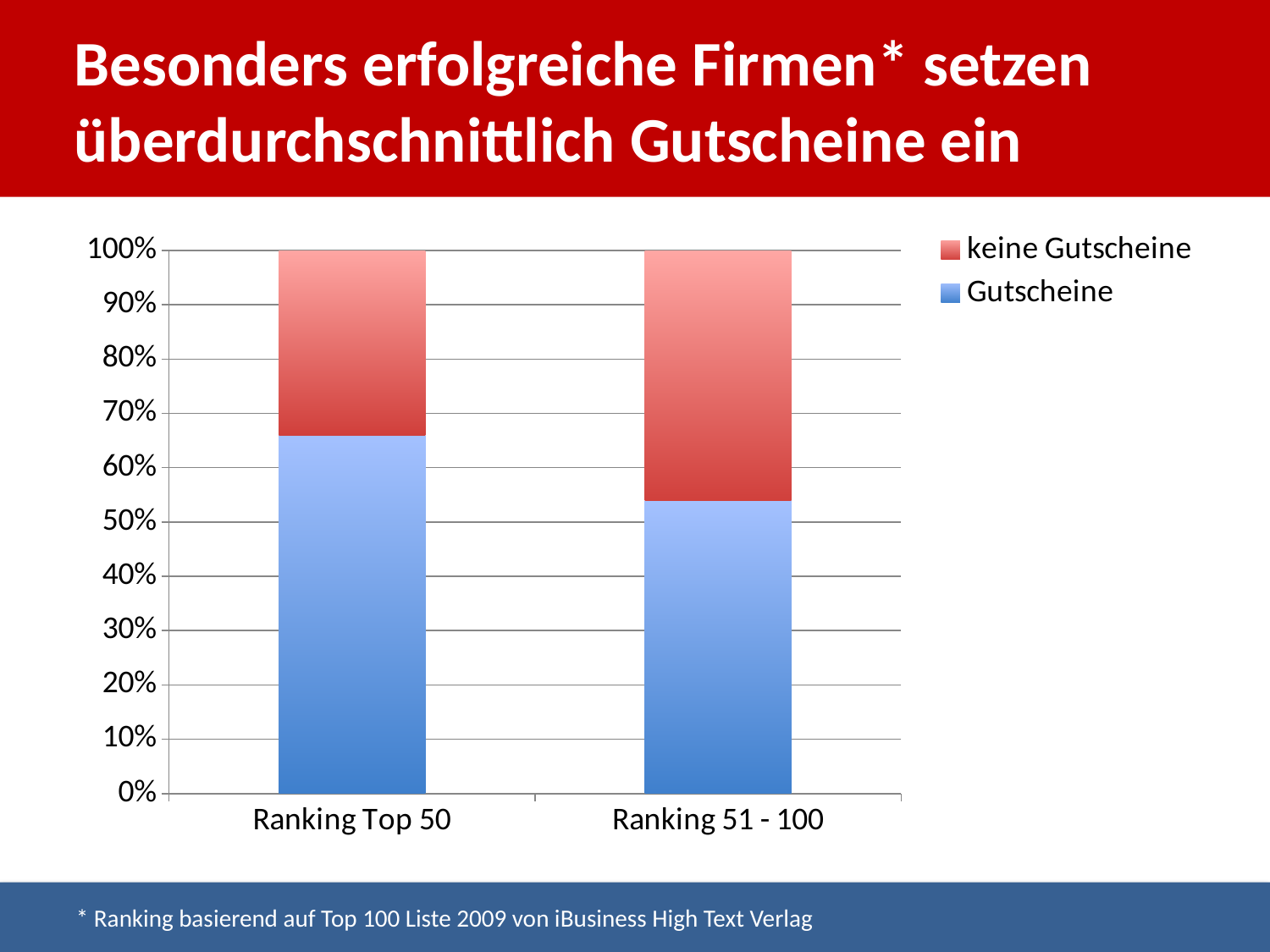
Is the 'Gutscheine' value for Ranking Top 50 greater or less than 70%? less Is the 'Gutscheine' value for Ranking 51 - 100 greater or less than 50%? greater What colour represents the series 'Gutscheine' in the chart? blue How many categories are shown on the x axis of the chart? 2 What is the total height of the stacked bar for Ranking Top 50? 100% How many series does the chart's legend list? 2 Which category has the larger 'keine Gutscheine' share, Ranking Top 50 or Ranking 51 - 100? Ranking 51 - 100 What kind of chart is shown on the slide? stacked bar chart Is the 'Gutscheine' value for Ranking Top 50 greater or less than 60%? greater Which series are listed in the chart's legend? keine Gutscheine, Gutscheine Which category has the larger 'Gutscheine' share, Ranking Top 50 or Ranking 51 - 100? Ranking Top 50